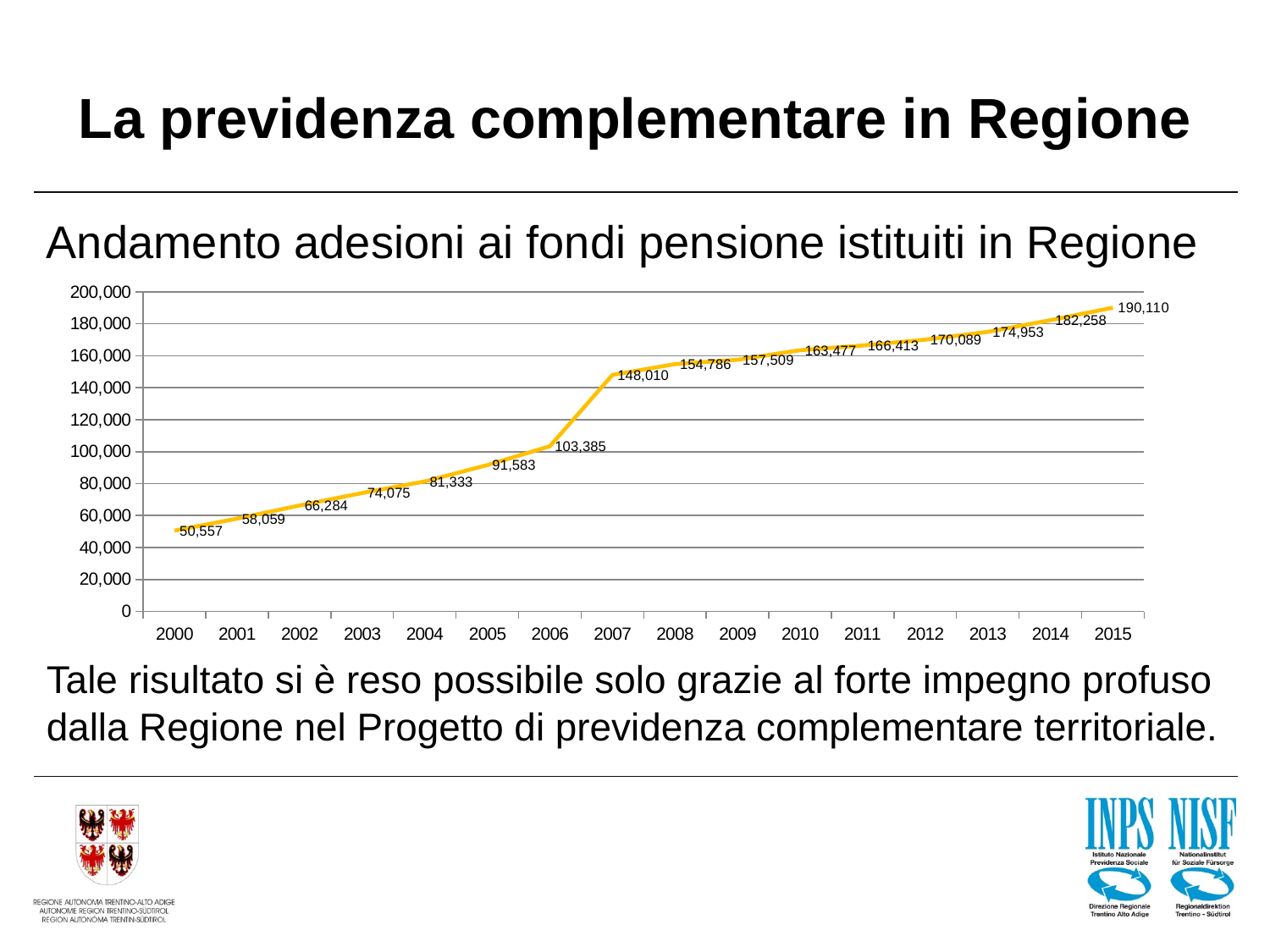
What is the difference between the values for 2015 and 2000? 139,553 What is the value for 2007? 148,010 What is the value for 2011? 166,413 What kind of chart is shown on the slide? line chart Which year has the highest value? 2015 Which year has the lowest value? 2000 How many years are plotted on the chart? 16 Which is larger, the value for 2005 or the value for 2009? 2009 What is the value for 2000? 50,557 What is the difference between the values for 2007 and 2006? 44,625 What is the value for 2015? 190,110 Is the value for 2004 greater or less than 100,000? less